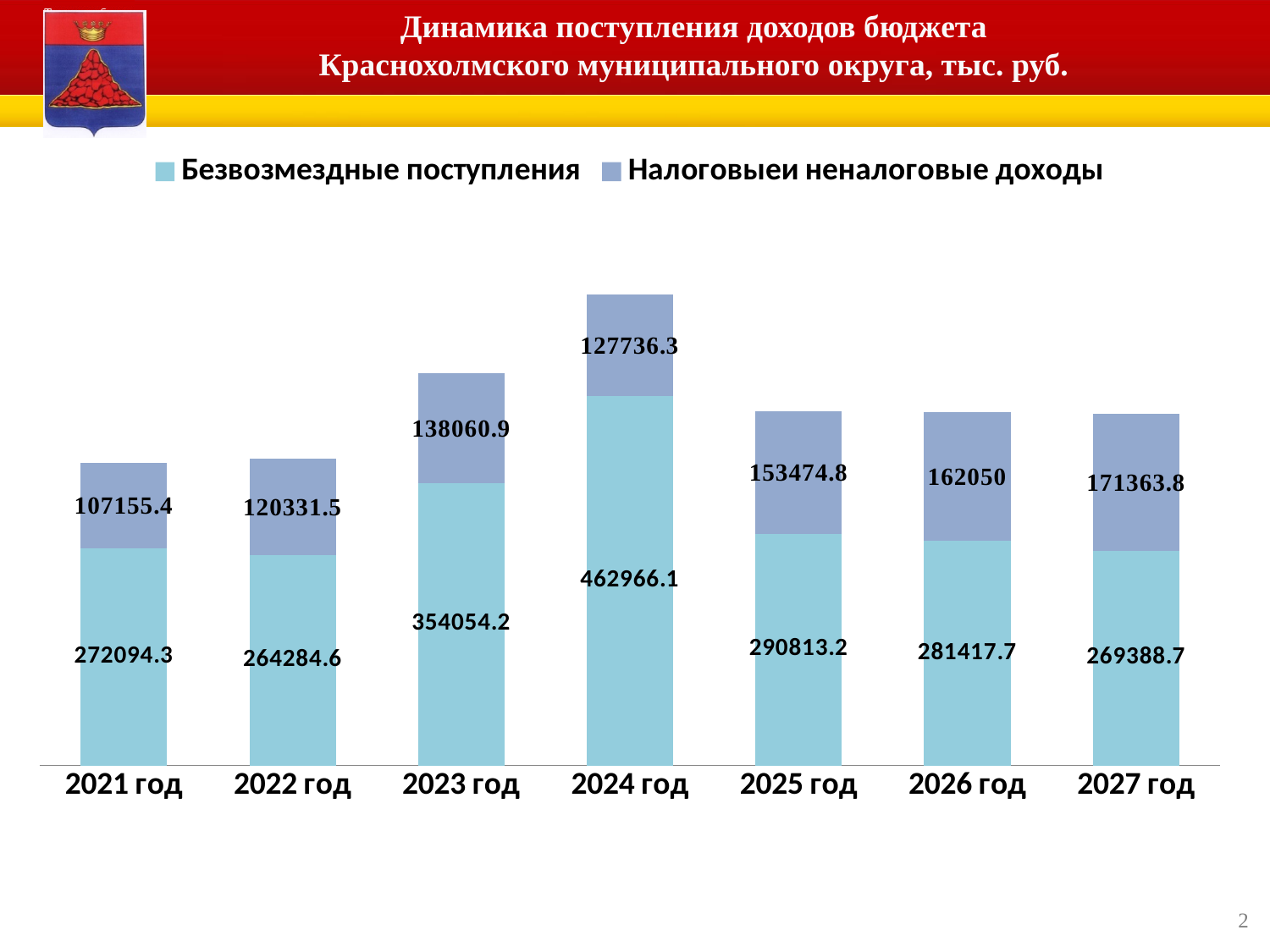
In which year is Безвозмездные поступления the highest? 2024 год What type of chart is shown on the slide? stacked bar chart In which year is Налоговые и неналоговые доходы the lowest? 2021 год What is the value of Безвозмездные поступления for 2024 год? 462966.1 How many years are shown on the x axis? 7 What is the value of Безвозмездные поступления for 2022 год? 264284.6 Do the values of Налоговые и неналоговые доходы rise or fall from 2025 год to 2027 год? rise How many series does the legend list? 2 What is the value of Налоговые и неналоговые доходы for 2026 год? 162050 Which is larger: Безвозмездные поступления in 2023 год or in 2025 год? 2023 год What is the difference between Налоговые и неналоговые доходы in 2027 год and 2021 год? 64208.4 What is the total of the stacked bar for 2024 год? 590702.4